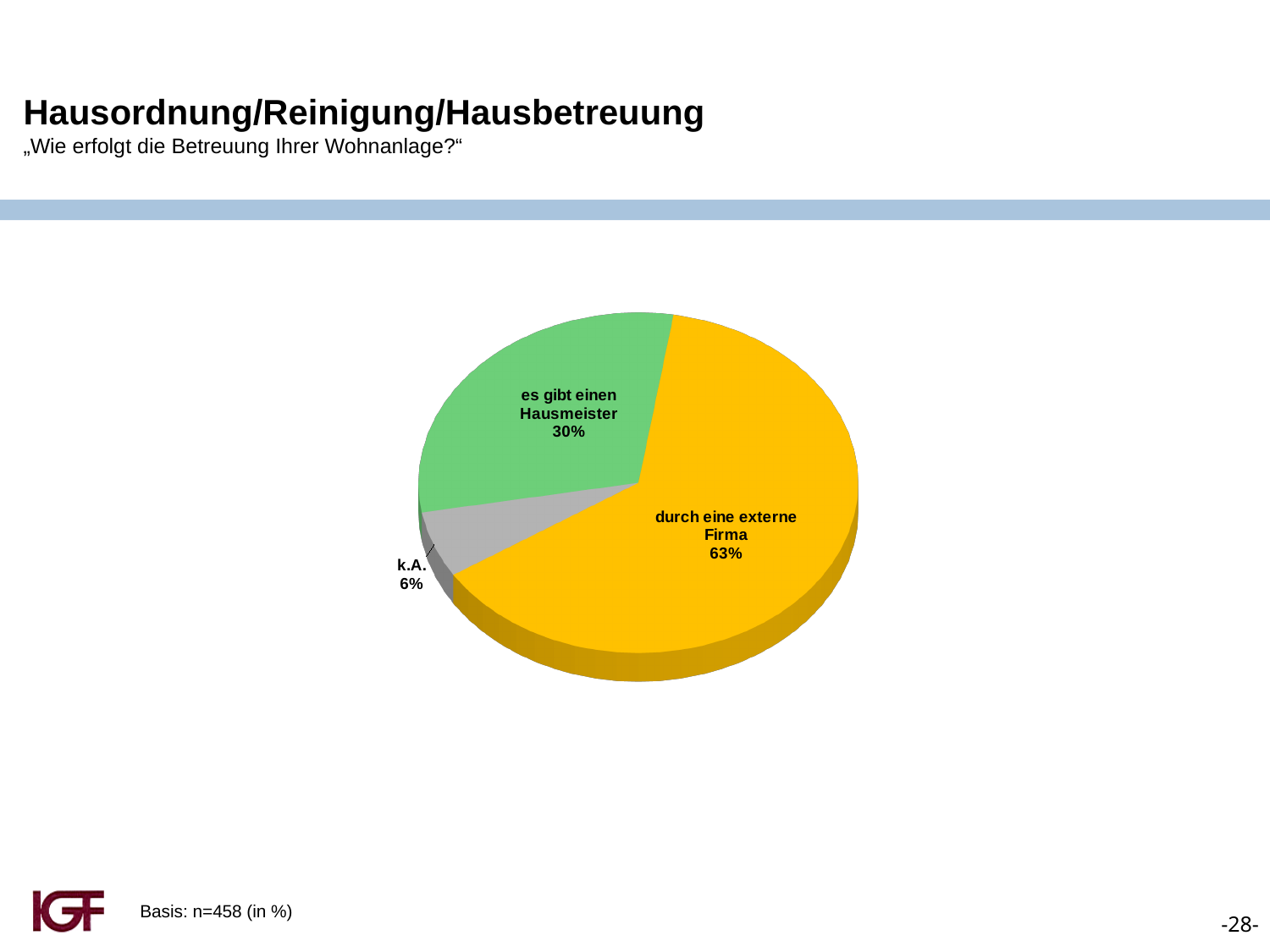
Which is larger: the share for "es gibt einen Hausmeister" or the share for "k.A."? es gibt einen Hausmeister What percentage of the pie is labelled "durch eine externe Firma"? 63% What percentage of the pie is labelled "es gibt einen Hausmeister"? 30% What colour is the slice for "es gibt einen Hausmeister"? green What kind of chart is shown on the slide? pie chart What is the difference in percentage points between "durch eine externe Firma" and "es gibt einen Hausmeister"? 33 Which slice of the pie is the smallest? k.A. What is the sample size (Basis) stated on the slide? n=458 What percentage of the pie is labelled "k.A."? 6% How many slices does the pie chart have? 3 Which slice of the pie is the largest? durch eine externe Firma